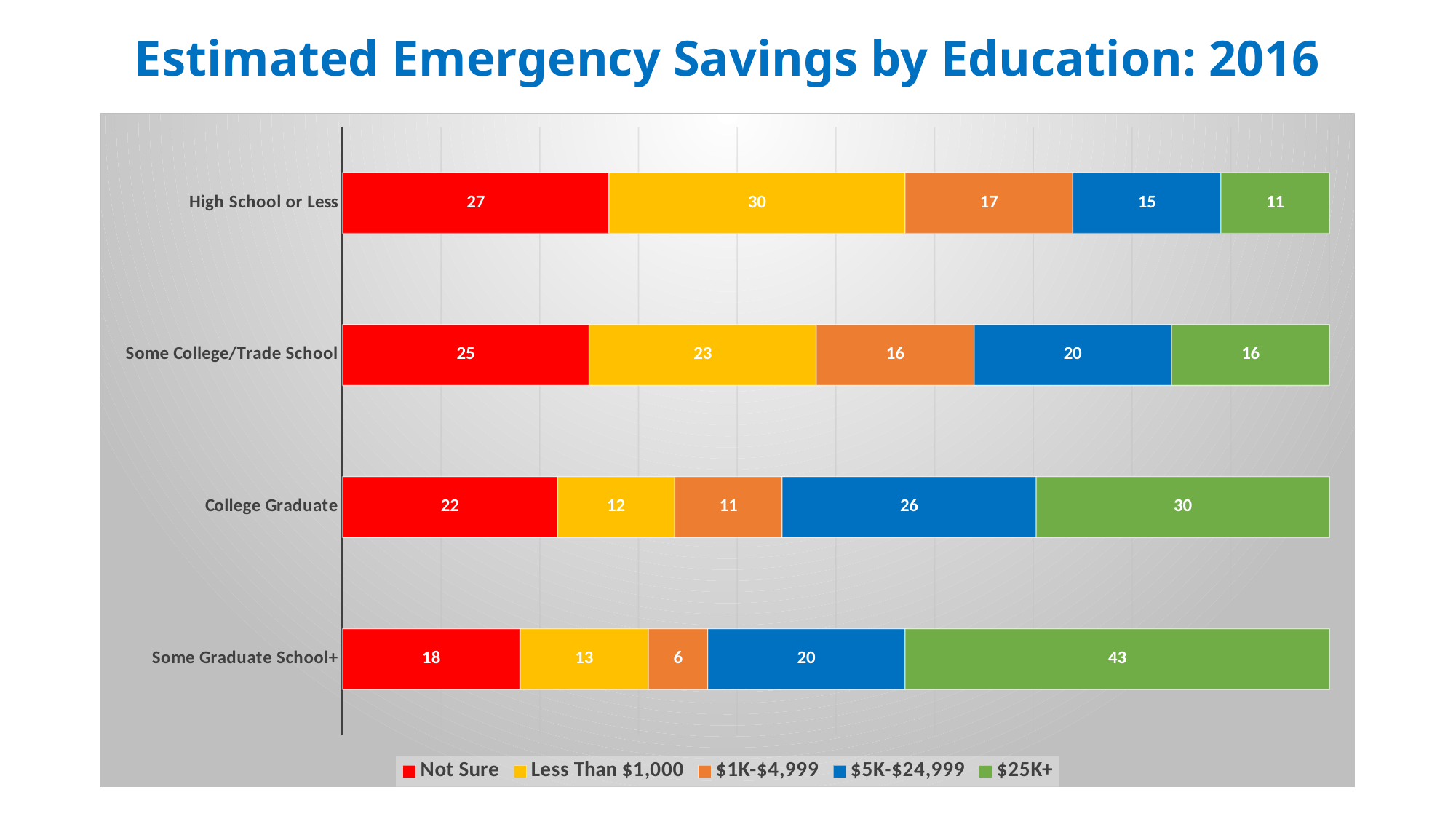
What is the value for "$5K-$24,999" for College Graduate? 26 What is the value for "$25K+" for Some Graduate School+? 43 Which education category has the lowest "$1K-$4,999" value? Some Graduate School+ What kind of chart is shown on the slide? Stacked bar chart What is the value for "Less Than $1,000" for High School or Less? 30 Which education category has the highest "Not Sure" value? High School or Less How many series does the legend list? 5 Which is larger: the "Less Than $1,000" value for Some College/Trade School or for College Graduate? Some College/Trade School What is the value for "$1K-$4,999" for Some College/Trade School? 16 What is the difference between the "$25K+" values for Some Graduate School+ and High School or Less? 32 What is the total of the stacked bar for College Graduate? 101 How many education categories are shown on the chart? 4